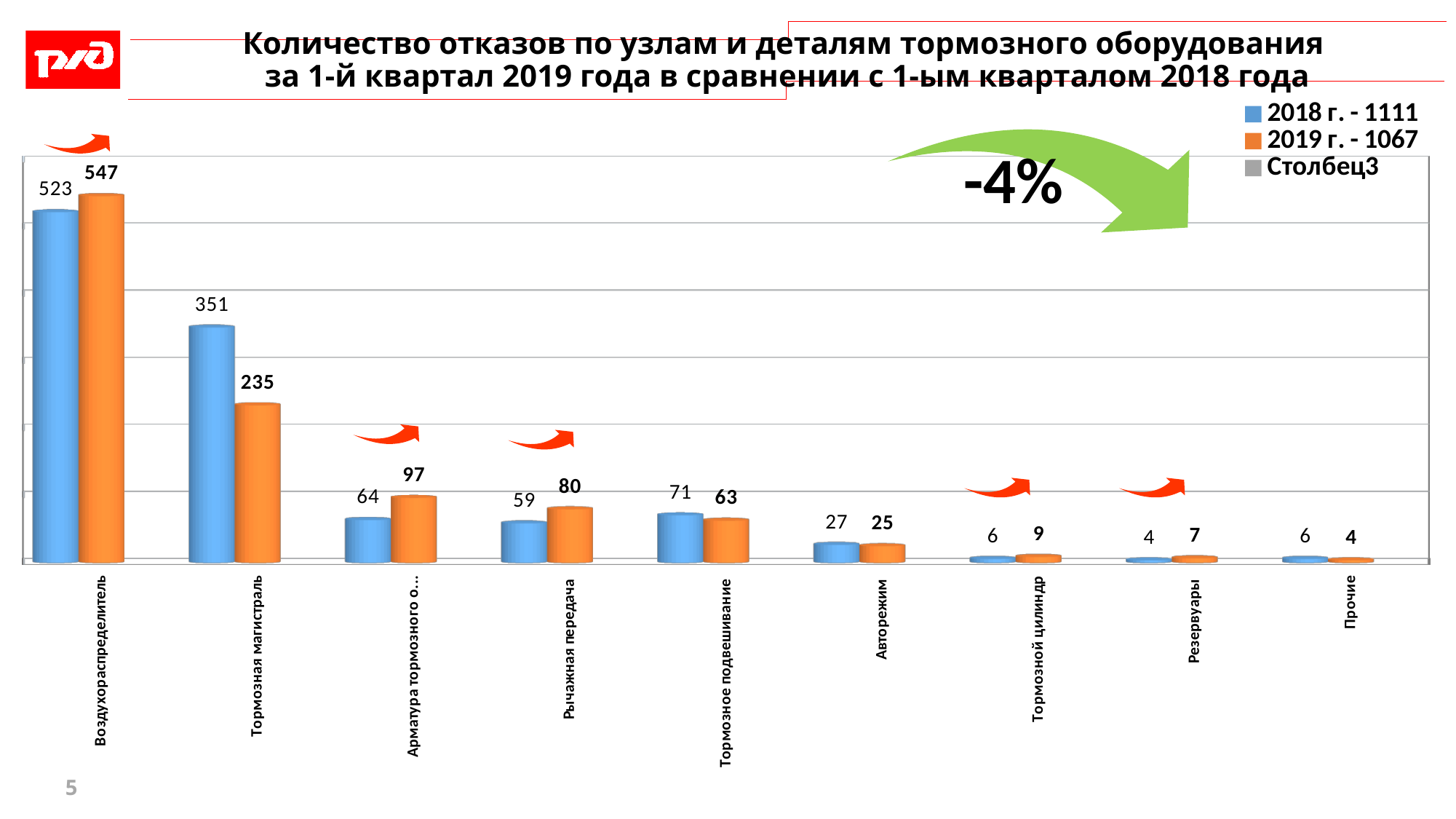
What is the difference between the 2018 and 2019 values for Тормозная магистраль? 116 How many categories are shown on the x axis? 9 Which category has the highest 2018 value? Воздухораспределитель What is the 2018 value for Тормозная магистраль? 351 How many series does the legend list? 3 For Тормозное подвешивание, which is larger: the 2018 value or the 2019 value? 2018 What kind of chart is shown on the slide? bar chart What is the 2019 value for Воздухораспределитель? 547 Which category has the lowest 2019 value? Прочие What is the difference between the 2019 and 2018 values for Авторежим? 2 What is the 2019 value for Рычажная передача? 80 What percentage change is shown in the large green arrow on the chart? -4%